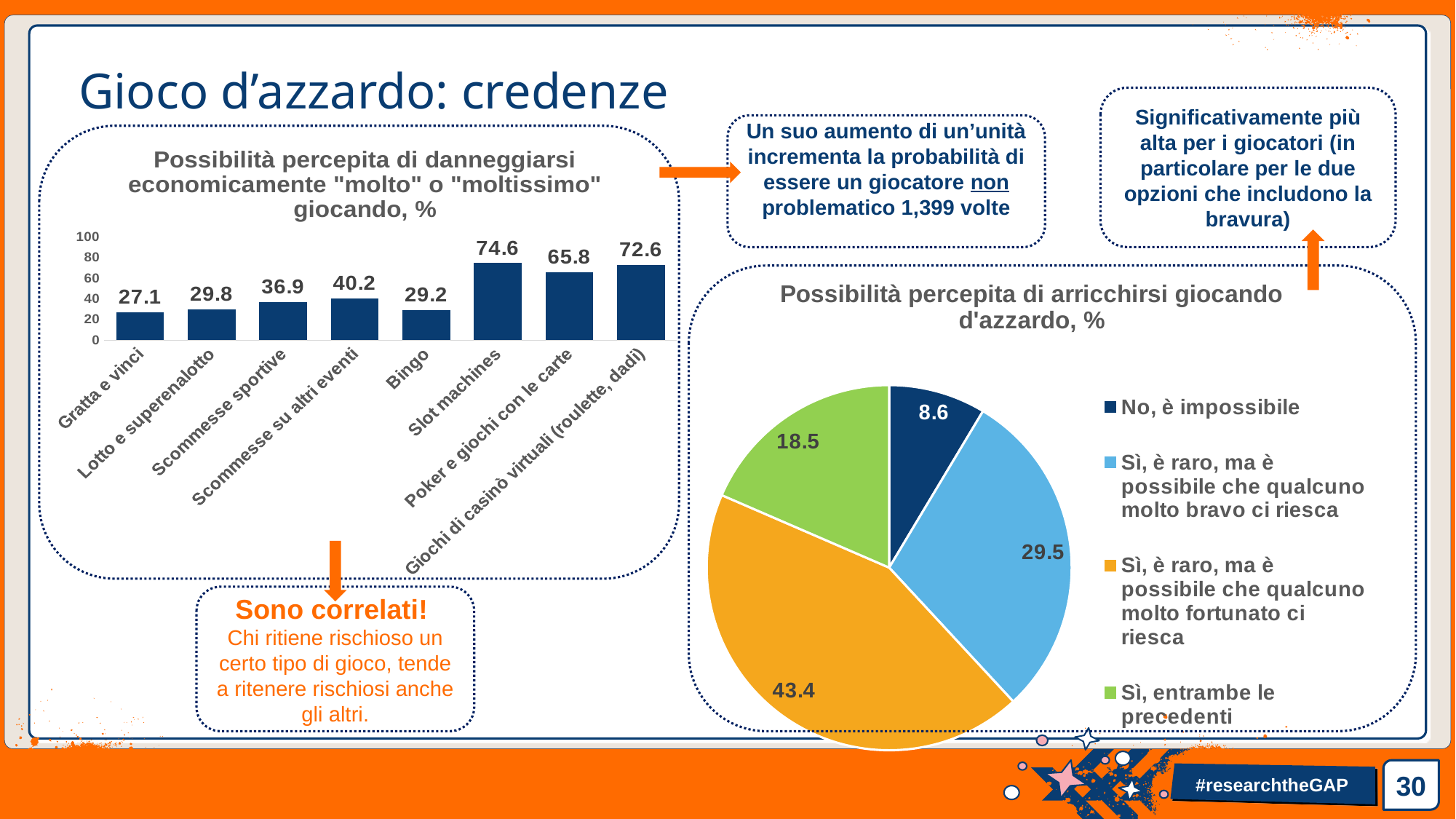
In the pie chart "Possibilità percepita di arricchirsi giocando d'azzardo", which slice is the largest? Sì, è raro, ma è possibile che qualcuno molto fortunato ci riesca In the bar chart "Possibilità percepita di danneggiarsi economicamente", what is the difference between Slot machines and Poker e giochi con le carte? 8.8 What kind of chart is "Possibilità percepita di danneggiarsi economicamente"? bar chart In the bar chart "Possibilità percepita di danneggiarsi economicamente", which category has the highest value? Slot machines In the bar chart "Possibilità percepita di danneggiarsi economicamente", which is larger: Scommesse sportive or Scommesse su altri eventi? Scommesse su altri eventi How many categories are shown in the bar chart "Possibilità percepita di danneggiarsi economicamente"? 8 In the bar chart "Possibilità percepita di danneggiarsi economicamente", which category has the lowest value? Gratta e vinci In the bar chart "Possibilità percepita di danneggiarsi economicamente", what is the value for Slot machines? 74.6 In the pie chart "Possibilità percepita di arricchirsi giocando d'azzardo", what is the value for "Sì, entrambe le precedenti"? 18.5 In the pie chart "Possibilità percepita di arricchirsi giocando d'azzardo", what is the value for "No, è impossibile"? 8.6 In the bar chart "Possibilità percepita di danneggiarsi economicamente", what is the value for Bingo? 29.2 How many entries does the legend of the pie chart "Possibilità percepita di arricchirsi giocando d'azzardo" list? 4